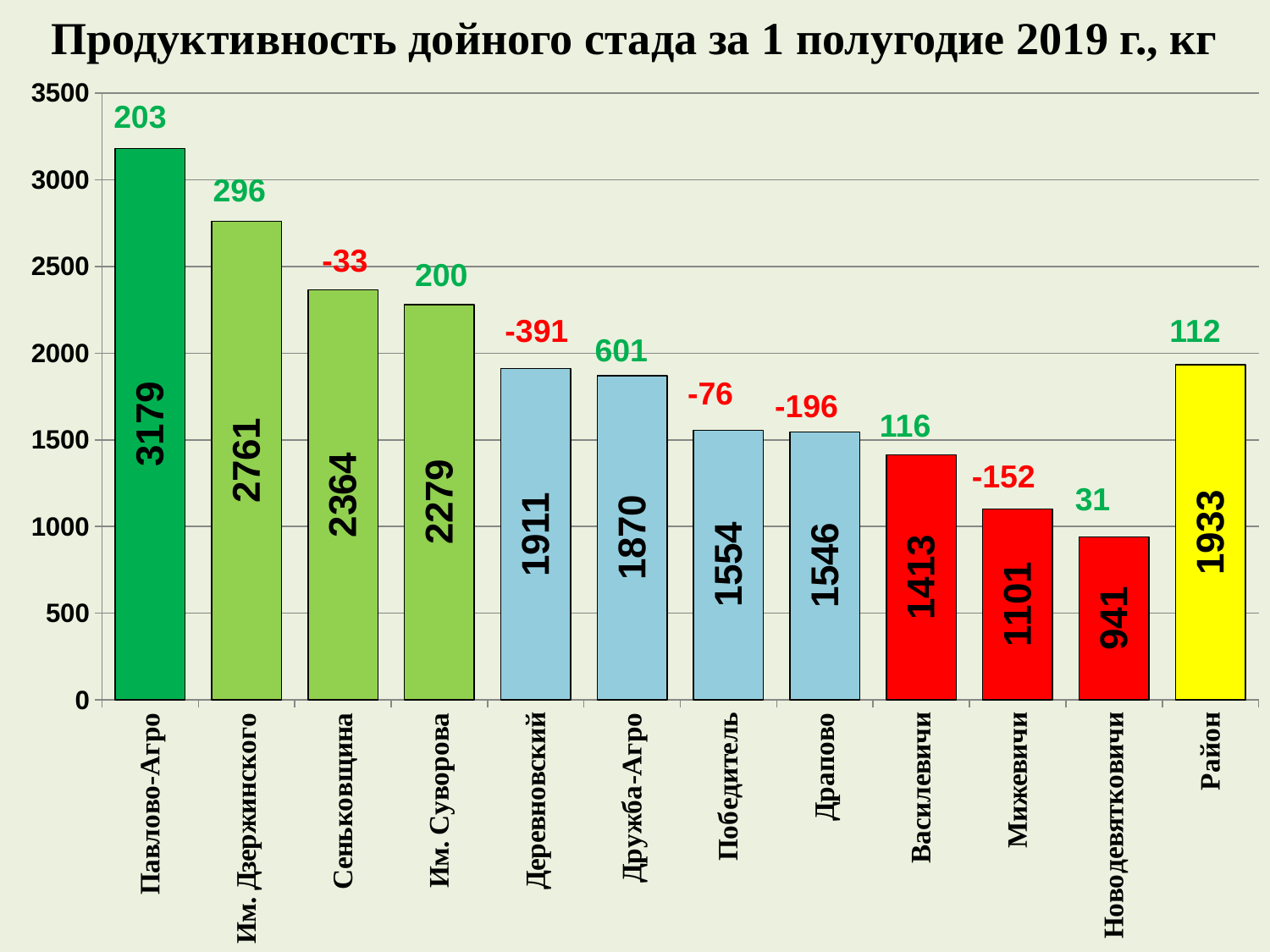
Is the value for Мижевичи greater or less than 1500? less What is the title of the chart? Продуктивность дойного стада за 1 полугодие 2019 г., кг What is the value for Район? 1933 What is the value for Павлово-Агро? 3179 What kind of chart is shown on the slide? bar chart What is the number printed in red above the bar for Деревновский? -391 Which category has the lowest value? Новодевятковичи What is the value for Дружба-Агро? 1870 How many bars are shown in the chart? 12 Which is larger, the value for Деревновский or the value for Район? Район Which category has the highest value? Павлово-Агро What is the difference between the values for Павлово-Агро and Им. Дзержинского? 418